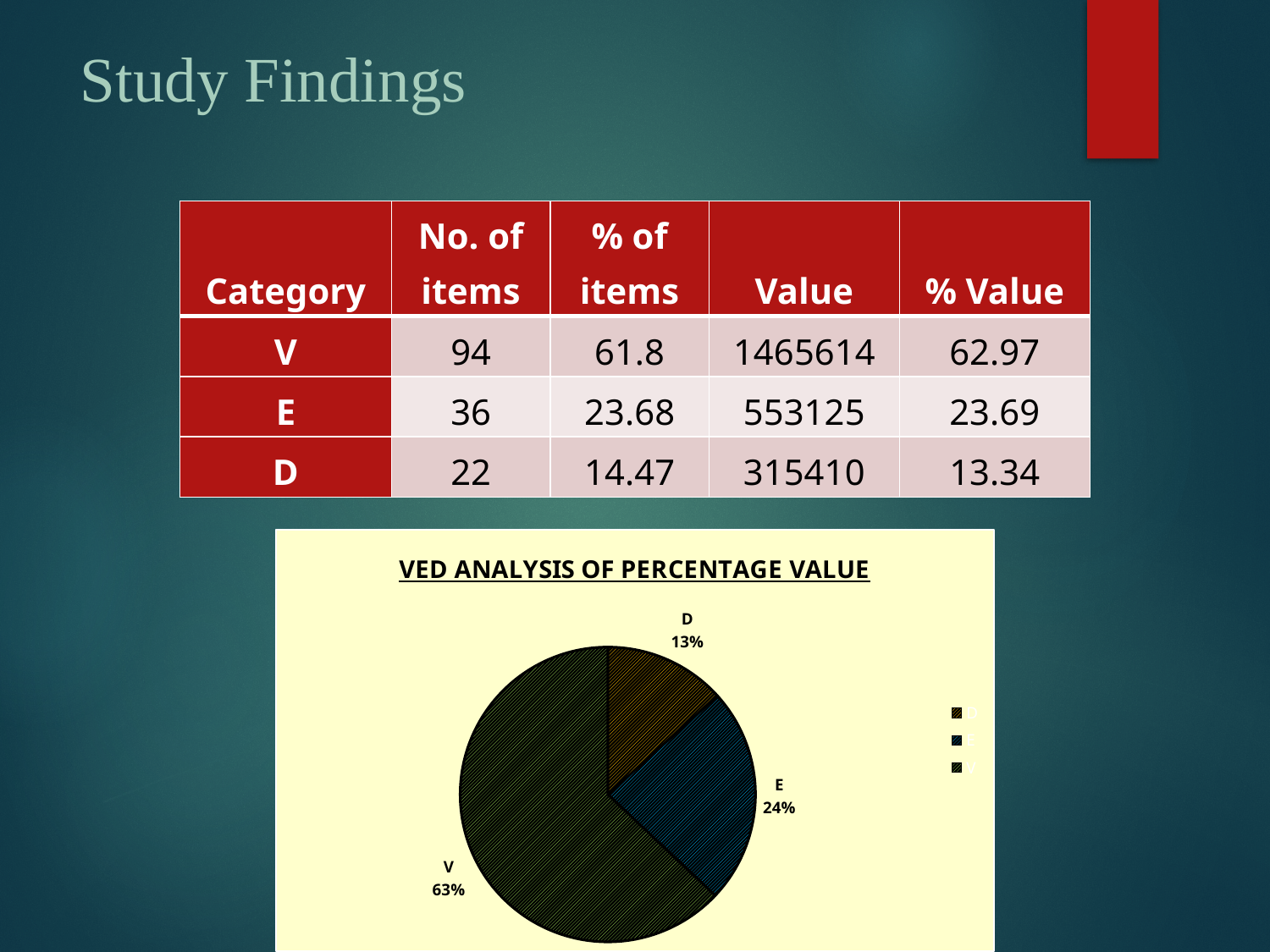
Which slice is larger, E or D? E Is the share for V greater or less than 50%? greater What is the difference in percentage points between the E slice and the D slice? 11 What share of the pie does category D have? 13% Which category has the largest slice of the pie? V What is the title of the chart? VED ANALYSIS OF PERCENTAGE VALUE What kind of chart is shown on the slide? pie chart What is the difference in percentage points between the V slice and the E slice? 39 How many slices does the pie chart have? 3 What share of the pie does category E have? 24% What share of the pie does category V have? 63% Which category has the smallest slice of the pie? D